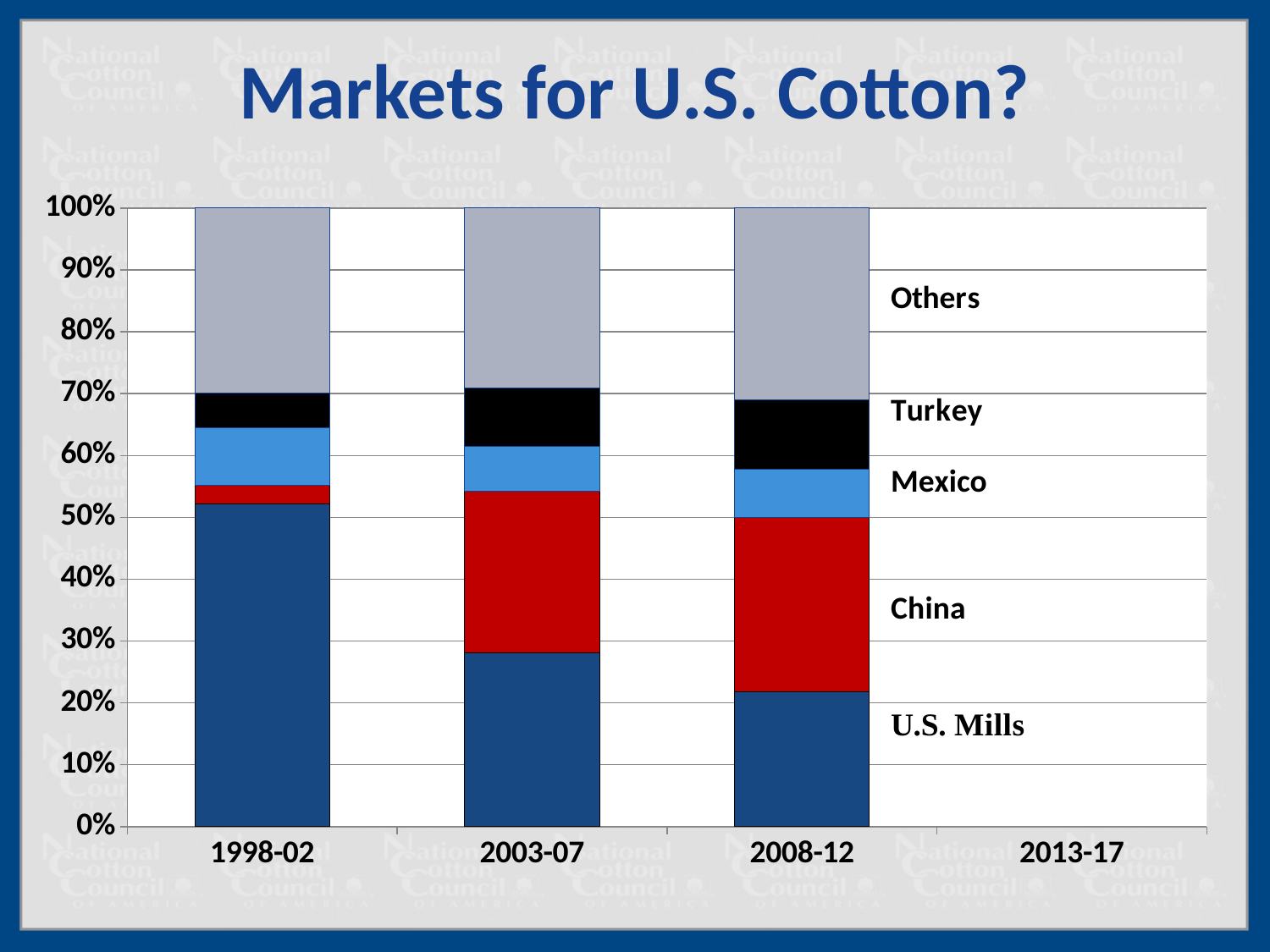
How many period labels appear on the x axis? 4 How many market segments are labeled on the chart? 5 Is the U.S. Mills share in 2003-07 greater or less than 40%? less In 2008-12, which segment is larger: China or U.S. Mills? China How many bars are plotted on the chart? 3 Is the U.S. Mills share in 2008-12 greater or less than 30%? less Which segment is shown in red? China Does the U.S. Mills share rise or fall from 1998-02 to 2008-12? Fall Is the U.S. Mills share in 1998-02 greater or less than 50%? greater What kind of chart is shown on the slide? Stacked bar chart In which period is the U.S. Mills share the largest? 1998-02 What is the title of the chart? Markets for U.S. Cotton?